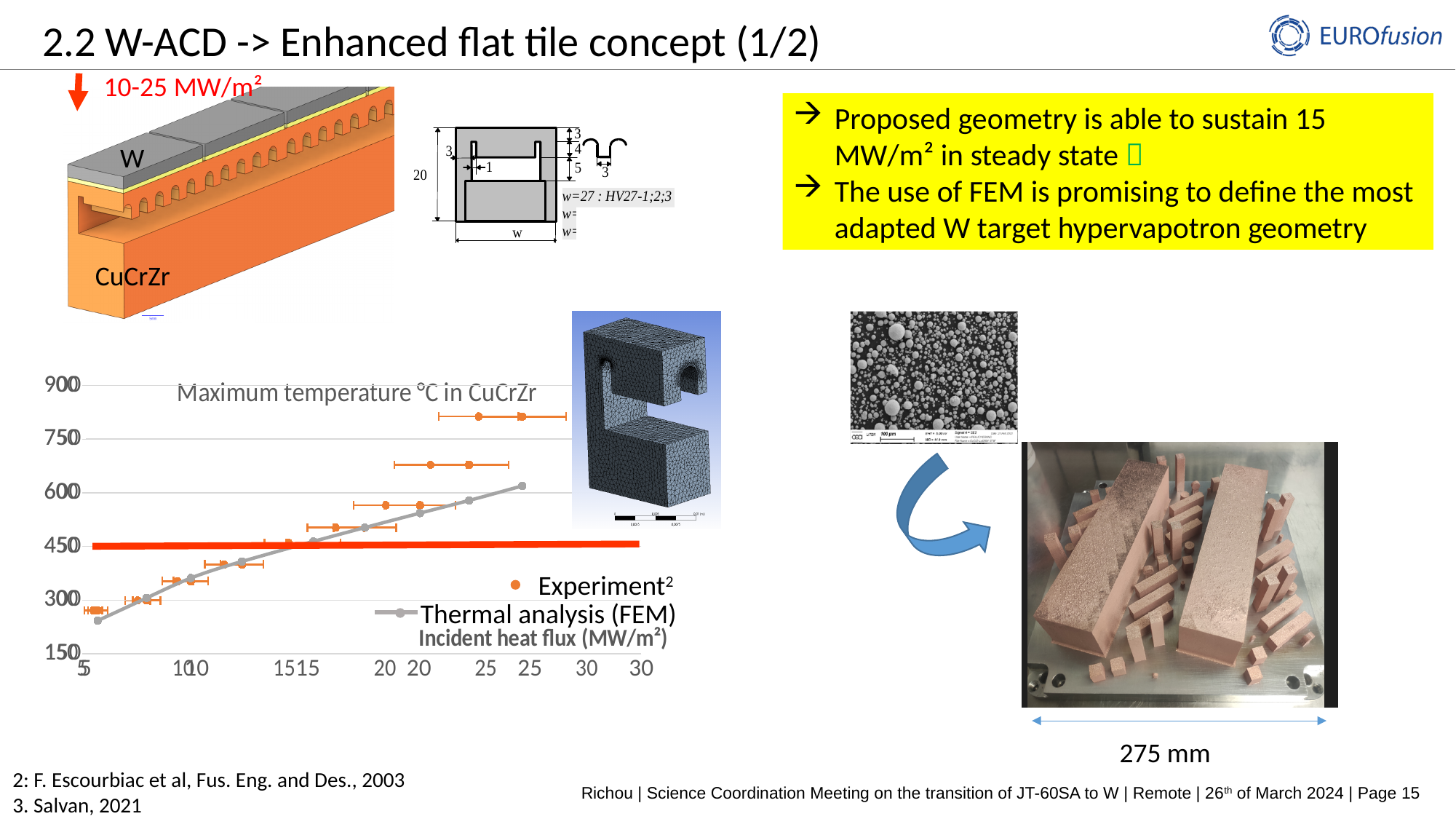
Is the Thermal analysis (FEM) temperature at the lowest heat flux plotted greater or less than 300? less What is the highest value shown on the y axis of the chart? 900 Does the maximum temperature in CuCrZr rise or fall as the incident heat flux increases? Rise What is the title of the chart? Maximum temperature °C in CuCrZr What kind of chart is shown on the slide? Scatter chart with a line What are the two series named in the chart legend? Experiment and Thermal analysis (FEM) How many series does the chart legend list? 2 Is the highest Experiment temperature value on the chart greater or less than 750? greater Is the Thermal analysis (FEM) temperature at 10 MW/m² greater or less than 450? less